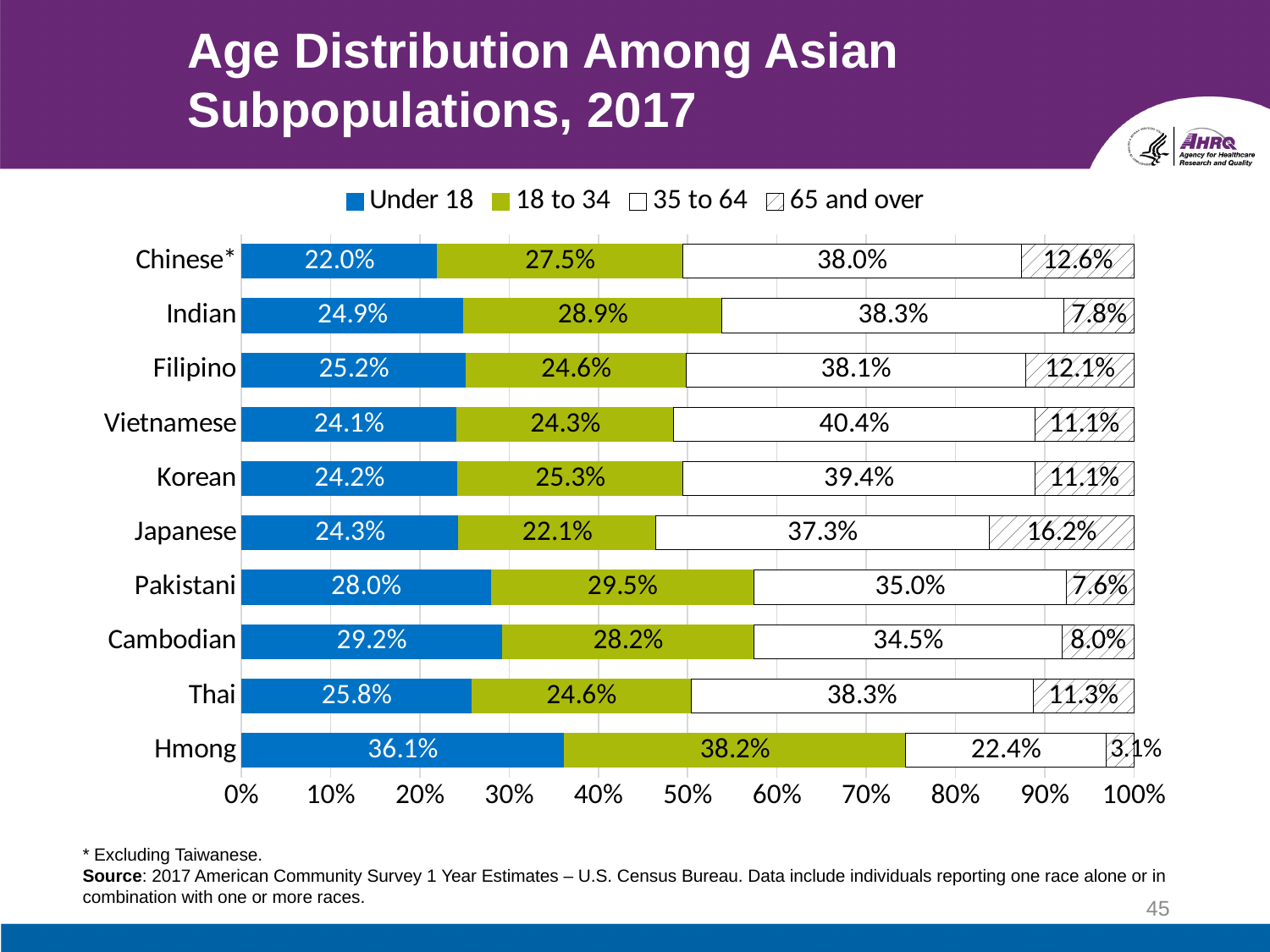
How many age groups does the legend list? 4 How many Asian subpopulations are shown on the chart? 10 What is the 65 and over value for Japanese? 16.2% What kind of chart is shown on the slide? Stacked bar chart Which has the larger Under 18 value, Pakistani or Cambodian? Cambodian Which subpopulation has the highest 65 and over share? Japanese What is the 35 to 64 value for Vietnamese? 40.4% What is the Under 18 value for Chinese*? 22.0% What is the 18 to 34 value for Hmong? 38.2% What is the difference in percentage points between the Under 18 value for Hmong and the Under 18 value for Chinese*? 14.1 Which subpopulation has the highest Under 18 share? Hmong Which subpopulation has the lowest 65 and over share? Hmong